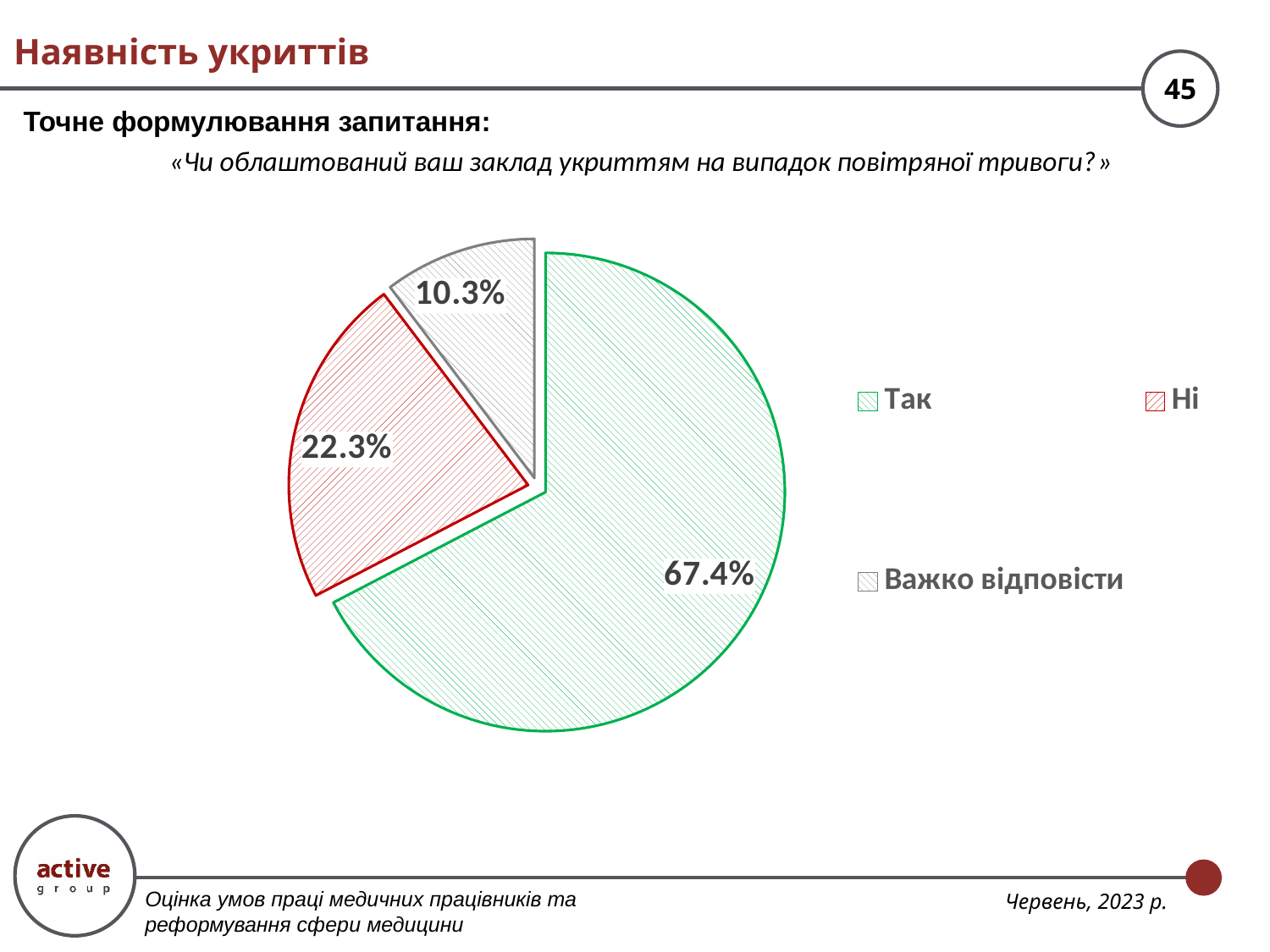
What colour is the outline of the "Ні" slice? red Which category has the largest slice of the pie? Так What is the difference in percentage points between the "Ні" and "Важко відповісти" slices? 12.0 What share of the pie is labelled "Ні"? 22.3% What is the difference in percentage points between the "Так" and "Ні" slices? 45.1 Which slice is larger, "Ні" or "Важко відповісти"? Ні What share of the pie is labelled "Так"? 67.4% How many slices does the pie chart have? 3 What share of the pie is labelled "Важко відповісти"? 10.3% What type of chart is shown on the slide? pie chart How many entries does the legend list? 3 Which category has the smallest slice of the pie? Важко відповісти